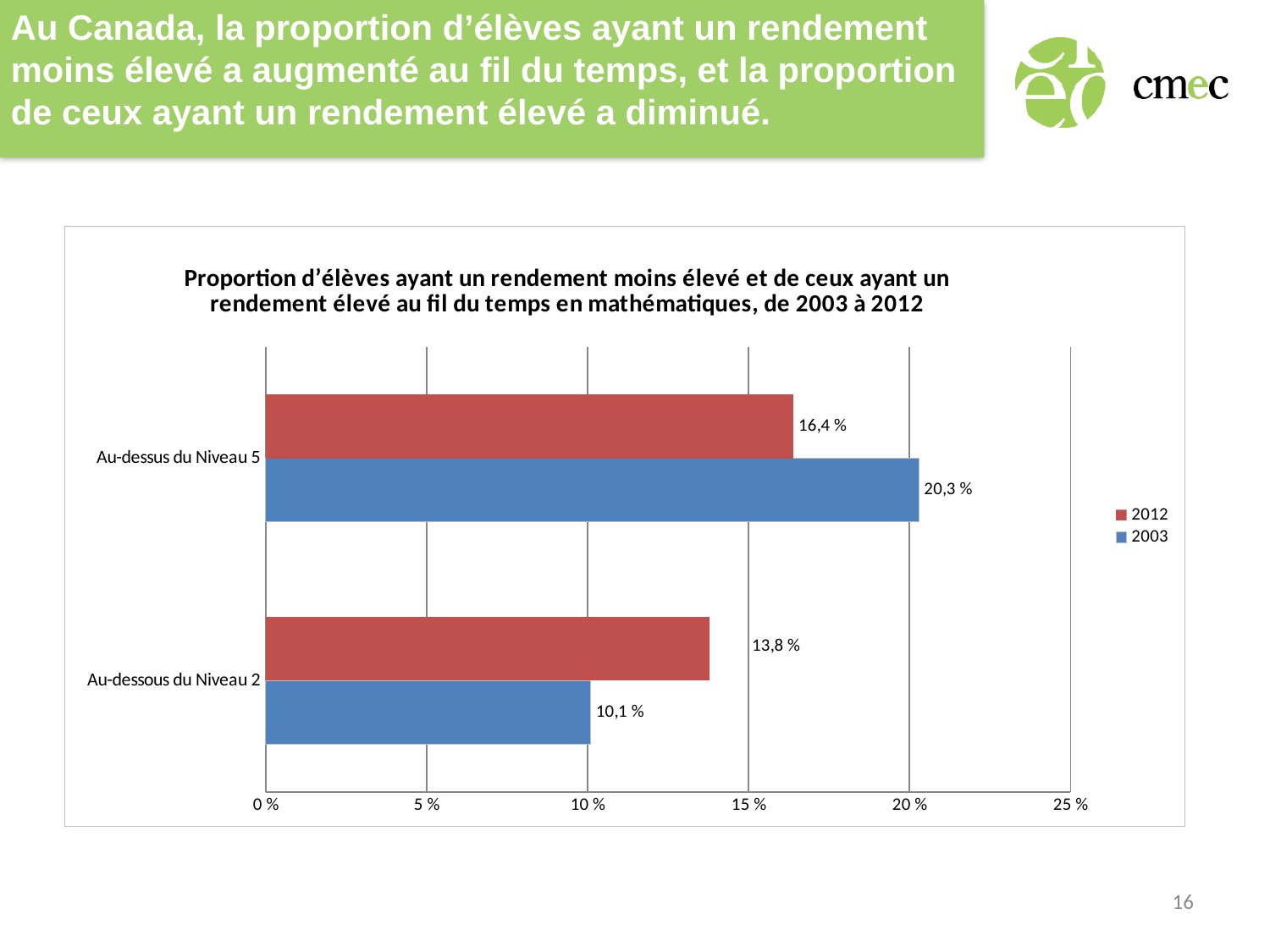
For "Au-dessous du Niveau 2", which year has the larger value, 2003 or 2012? 2012 What is the value for 2012 for "Au-dessous du Niveau 2"? 13,8 % What is the difference between the 2003 and 2012 values for "Au-dessus du Niveau 5"? 3,9 % Is the 2003 value for "Au-dessus du Niveau 5" greater or less than 20 %? greater What is the value for 2003 for "Au-dessus du Niveau 5"? 20,3 % Which bar has the highest value on the chart? 2003, Au-dessus du Niveau 5 How many series does the legend list? 2 What is the difference between the 2012 and 2003 values for "Au-dessous du Niveau 2"? 3,7 % What is the value for 2003 for "Au-dessous du Niveau 2"? 10,1 % What is the value for 2012 for "Au-dessus du Niveau 5"? 16,4 % Which bar has the lowest value on the chart? 2003, Au-dessous du Niveau 2 What kind of chart is shown on the slide? Bar chart